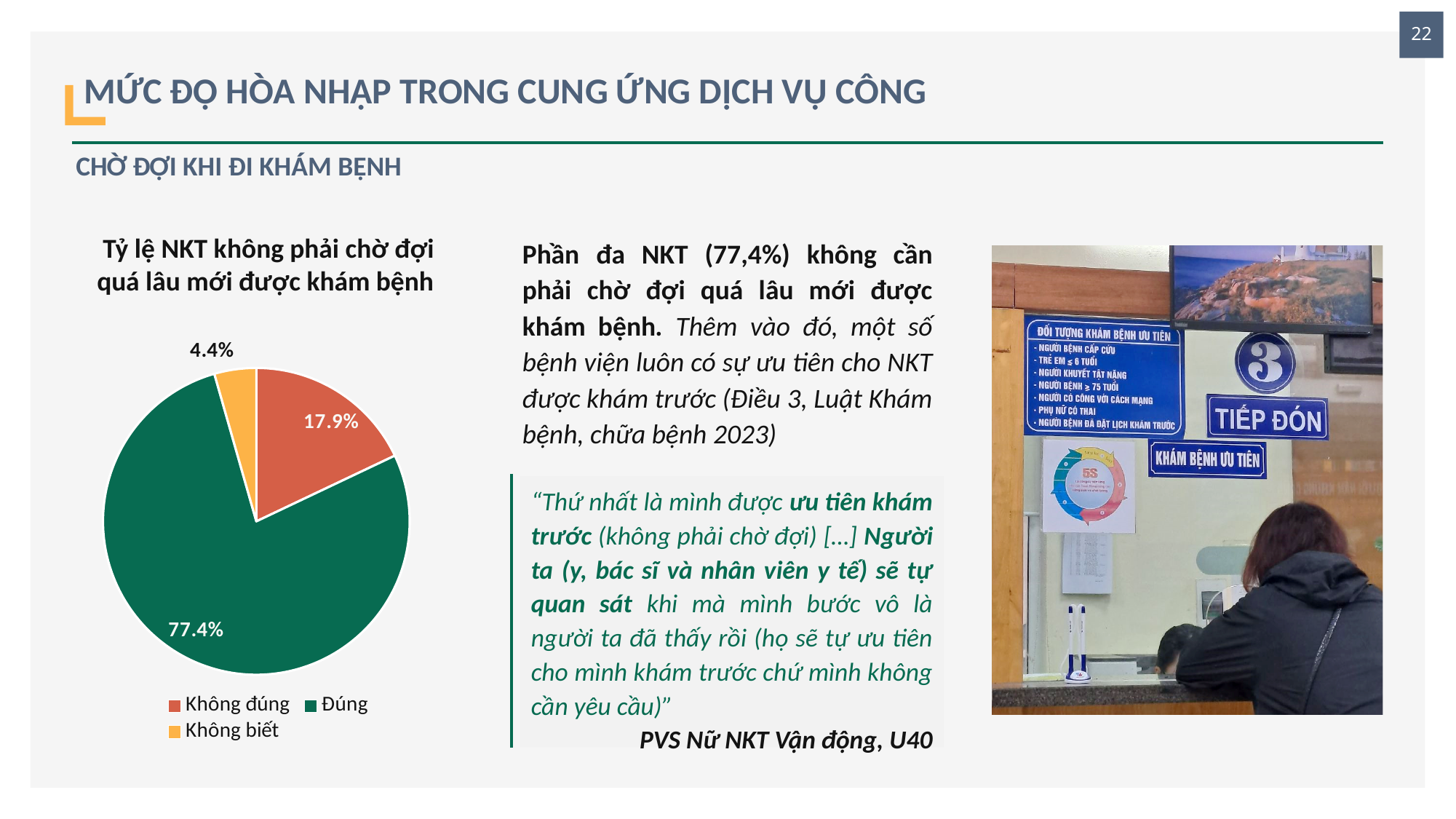
Which category has the largest slice in the pie chart? Đúng What is the difference between the "Đúng" and "Không đúng" values in the pie chart? 59.5% What colour is the "Đúng" slice in the pie chart? Green What kind of chart is shown on the slide? Pie chart What is the value for "Không biết" in the pie chart? 4.4% What is the value for "Đúng" in the pie chart? 77.4% What is the value for "Không đúng" in the pie chart? 17.9% Which category has the smallest slice in the pie chart? Không biết What is the difference between the "Không đúng" and "Không biết" values in the pie chart? 13.5% How many categories does the pie chart show? 3 What is the title of the pie chart? Tỷ lệ NKT không phải chờ đợi quá lâu mới được khám bệnh Which is larger in the pie chart, "Không đúng" or "Không biết"? Không đúng